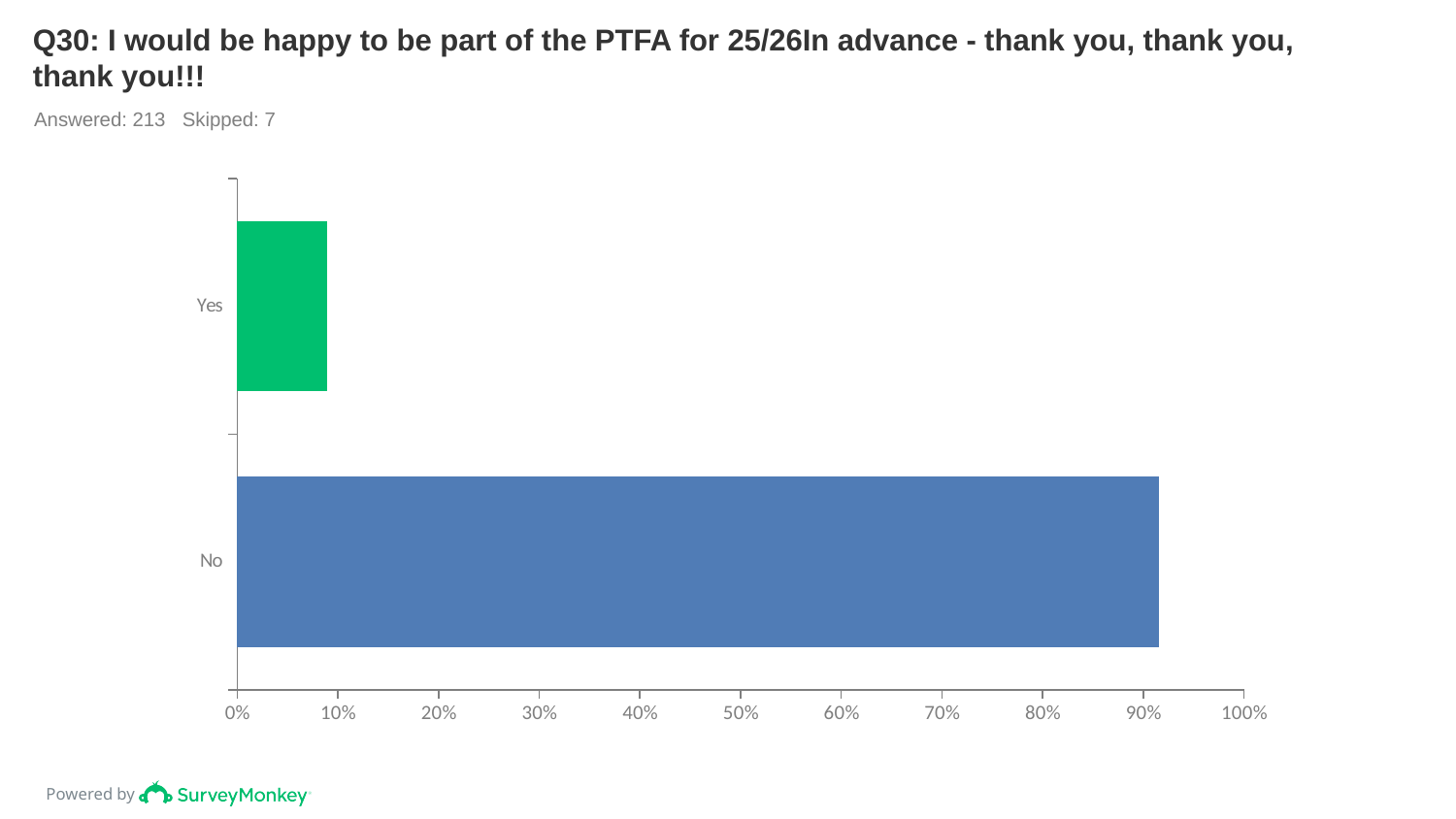
Is the value for No greater or less than 80%? greater What kind of chart is shown on the slide? bar chart How many respondents answered this question according to the slide? 213 Which category has the lowest value? Yes Which is larger, the value for Yes or the value for No? No How many categories are plotted in the chart? 2 Is the value for Yes greater or less than 20%? less What is the highest value shown on the x axis? 100% Is the value for Yes greater or less than 50%? less Which category has the highest value? No